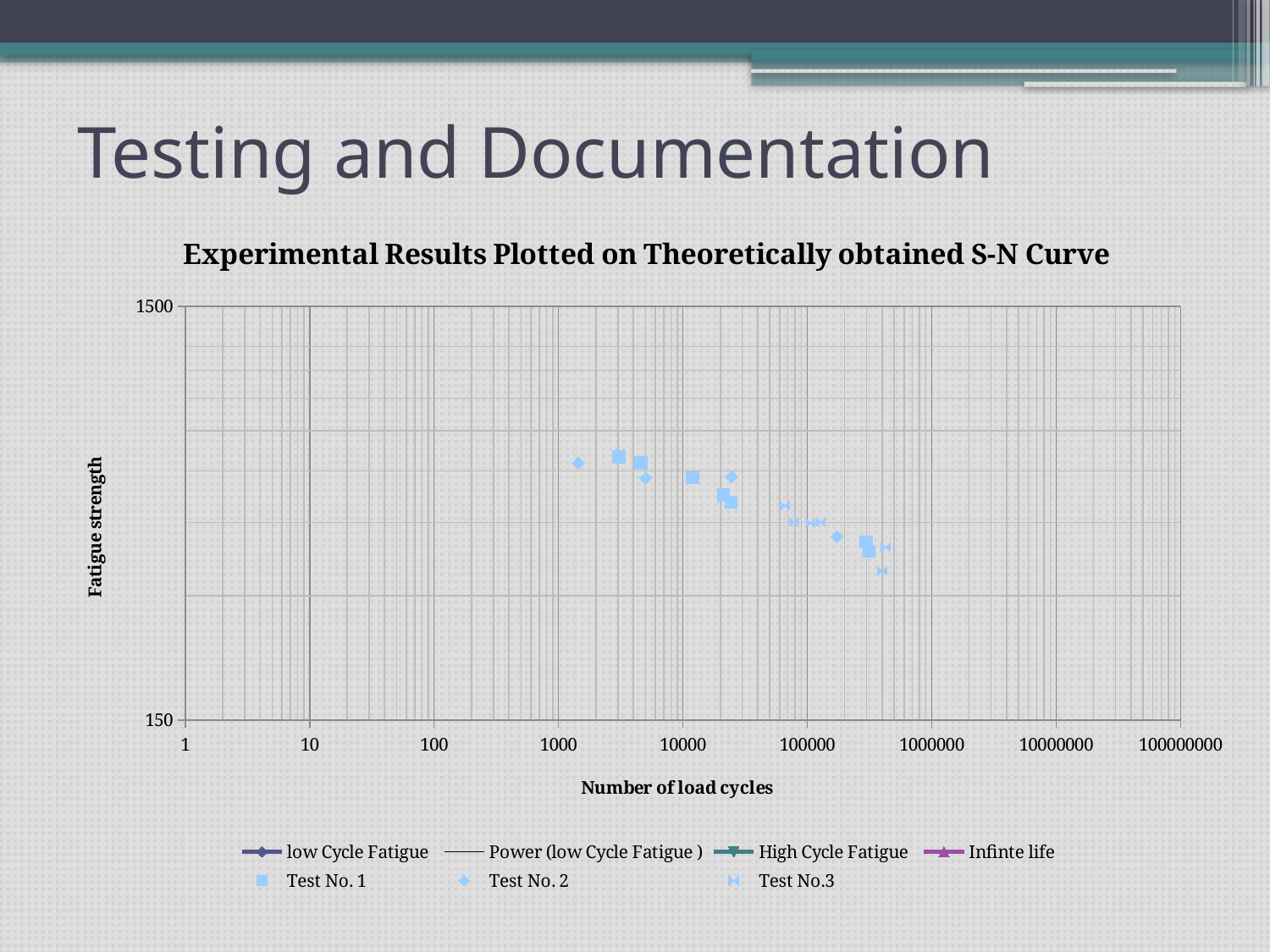
Are the plotted fatigue strength values greater or less than 1500? less Is the number of load cycles for the Test No.3 points greater or less than 10000? greater What kind of chart is shown on the slide? Scatter chart How many series does the chart legend list? 7 Are the plotted fatigue strength values greater or less than 150? greater What is the label of the x axis? Number of load cycles What is the title of the chart? Experimental Results Plotted on Theoretically obtained S-N Curve Do the plotted fatigue strength values rise or fall as the number of load cycles increases? Fall